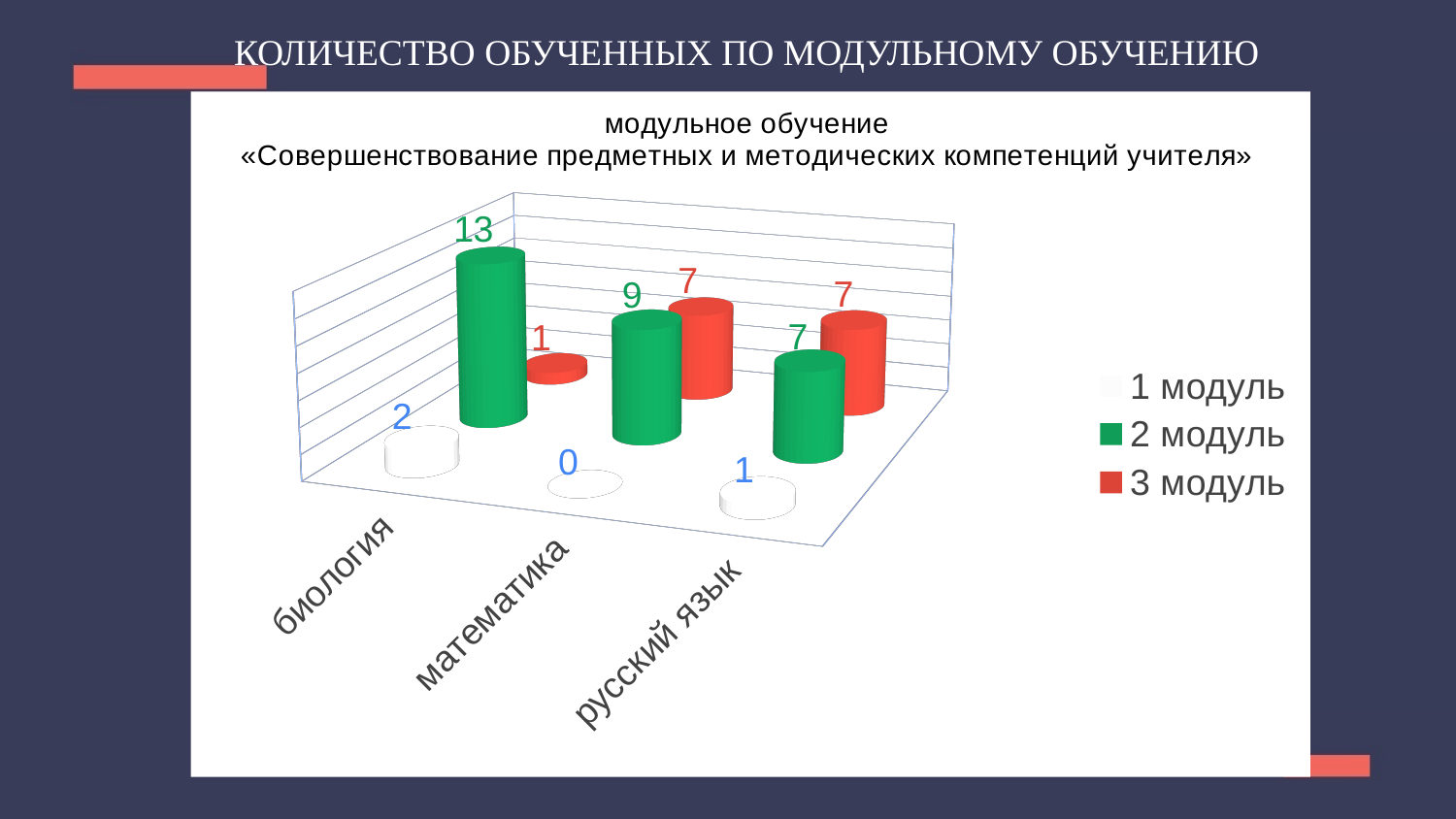
Which is larger: the 2 модуль value for русский язык or the 3 модуль value for биология? 2 модуль value for русский язык What is the value for 3 модуль in математика? 7 Which category has the highest value for 2 модуль? биология Which colour represents 3 модуль in the legend? red What is the value for 1 модуль in русский язык? 1 How many categories are shown on the x axis? 3 What kind of chart is shown on the slide? bar chart What is the difference between the 2 модуль values for биология and математика? 4 Which category has the lowest value for 3 модуль? биология How many series does the legend list? 3 What is the value for 2 модуль in биология? 13 What is the value for 1 модуль in математика? 0